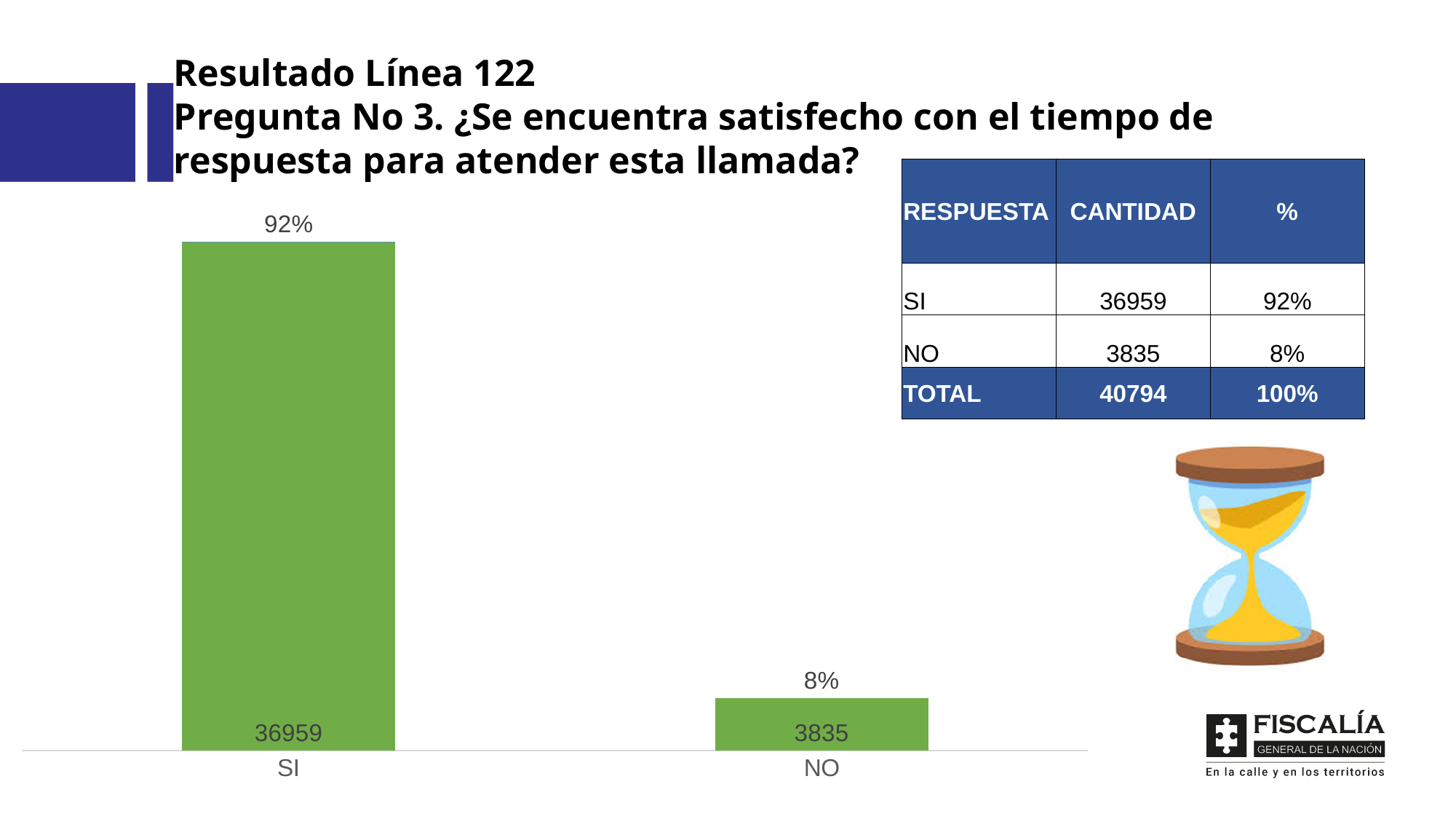
What is the count value shown for the SI bar? 36959 What is the count value shown for the NO bar? 3835 What is the difference between the SI count and the NO count? 33124 How many categories are shown in the chart? 2 Which category has the highest value? SI What percentage is shown above the NO bar? 8% What is the difference in percentage points between SI and NO? 84 What kind of chart is shown on the slide? bar chart What percentage is shown above the SI bar? 92% Which is larger, the value for SI or the value for NO? SI Which category has the lowest value? NO What colour are the bars in the chart? green